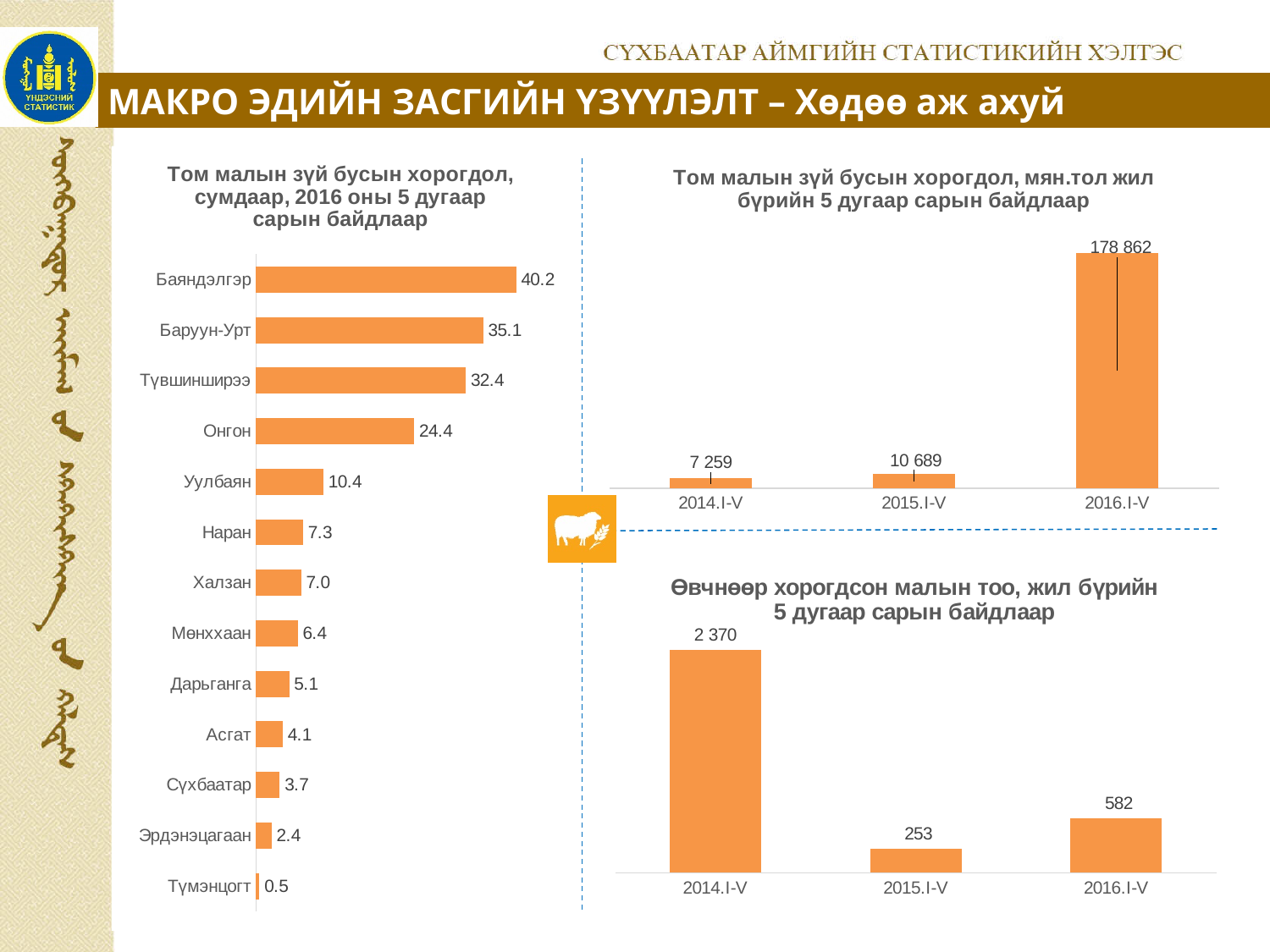
In the bottom right chart (Өвчнөөр хорогдсон малын тоо), which year has the highest value? 2014.I-V What kind of chart is the left chart (Том малын зүй бусын хорогдол, сумдаар)? Bar chart In the top right chart (Том малын зүй бусын хорогдол, мян.тол), what is the difference between the values for 2015.I-V and 2014.I-V? 3 430 In the top right chart (Том малын зүй бусын хорогдол, мян.тол), what is the value for 2016.I-V? 178 862 In the top right chart (Том малын зүй бусын хорогдол, мян.тол), do the values rise or fall from 2014.I-V to 2016.I-V? Rise In the left chart (Том малын зүй бусын хорогдол, сумдаар), which category has the lowest value? Түмэнцогт In the left chart (Том малын зүй бусын хорогдол, сумдаар), which is larger, the value for Наран or the value for Халзан? Наран In the left chart (Том малын зүй бусын хорогдол, сумдаар), which category has the highest value? Баяндэлгэр In the bottom right chart (Өвчнөөр хорогдсон малын тоо), what is the value for 2015.I-V? 253 In the left chart (Том малын зүй бусын хорогдол, сумдаар), what is the value for Баяндэлгэр? 40.2 In the left chart (Том малын зүй бусын хорогдол, сумдаар), what is the difference between the values for Баруун-Урт and Онгон? 10.7 In the left chart (Том малын зүй бусын хорогдол, сумдаар), how many categories are shown? 13